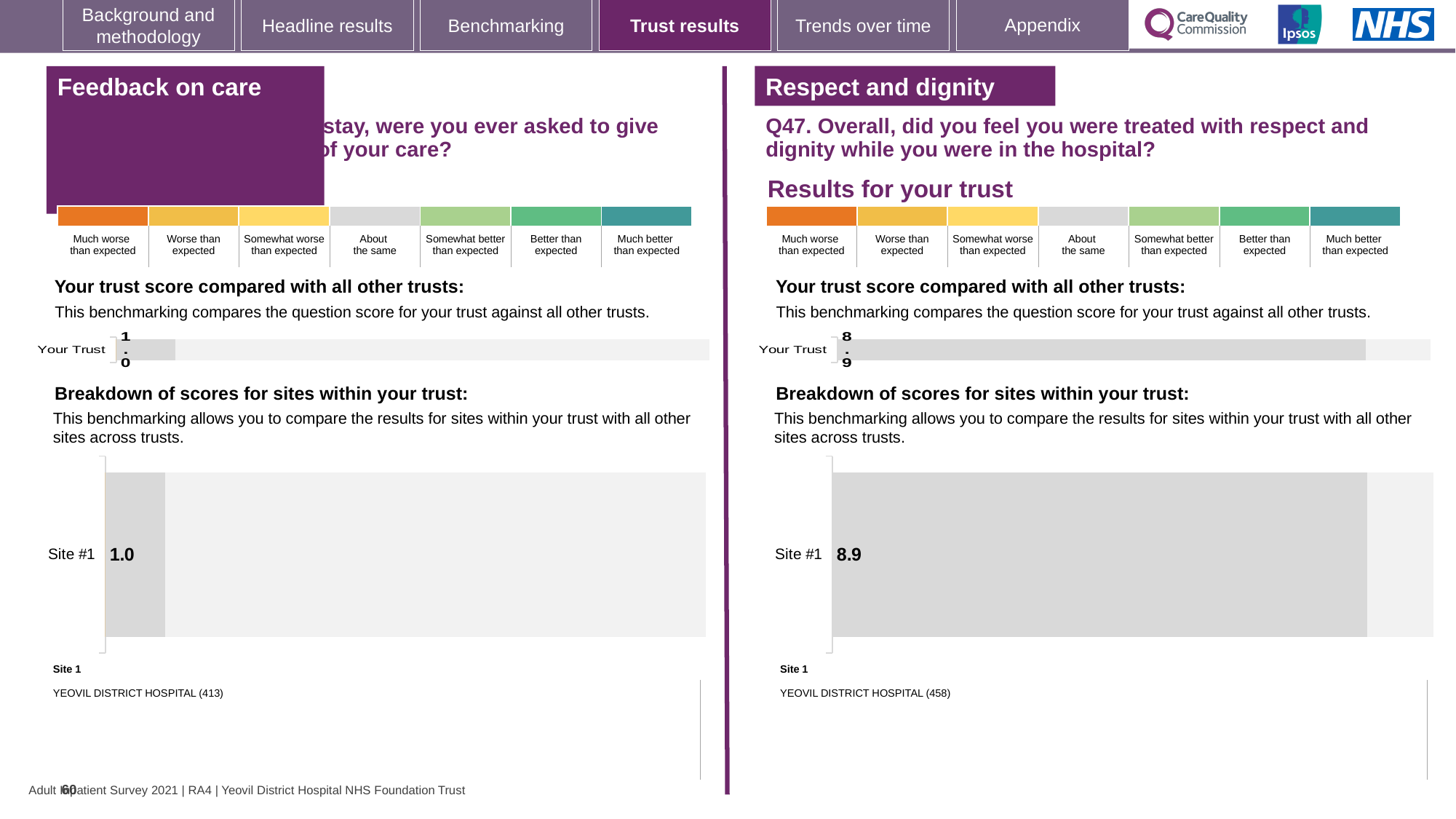
What is the name of the site listed as Site 1 under the 'Respect and dignity' breakdown chart? YEOVIL DISTRICT HOSPITAL (458) What type of chart is used for the Site #1 breakdown in the 'Respect and dignity' section? Bar chart In the 'Respect and dignity' section, what score is shown for Site #1 in the breakdown of scores for sites within your trust? 8.9 What is the difference between the Site #1 score in the 'Respect and dignity' breakdown chart and the Site #1 score in the 'Feedback on care' breakdown chart? 7.9 In the 'Respect and dignity' section, what is the score shown for Your Trust in the chart comparing the trust score with all other trusts? 8.9 What is the name of the site listed as Site 1 under the 'Feedback on care' breakdown chart? YEOVIL DISTRICT HOSPITAL (413) In the 'Feedback on care' section, what is the score shown for Your Trust in the chart comparing the trust score with all other trusts? 1.0 How many sites are shown in the 'Respect and dignity' breakdown of scores for sites within your trust chart? 1 How many sites are shown in the 'Feedback on care' breakdown of scores for sites within your trust chart? 1 In the 'Feedback on care' section, what score is shown for Site #1 in the breakdown of scores for sites within your trust? 1.0 Which Site #1 score is larger: the one in the 'Feedback on care' breakdown chart or the one in the 'Respect and dignity' breakdown chart? Respect and dignity